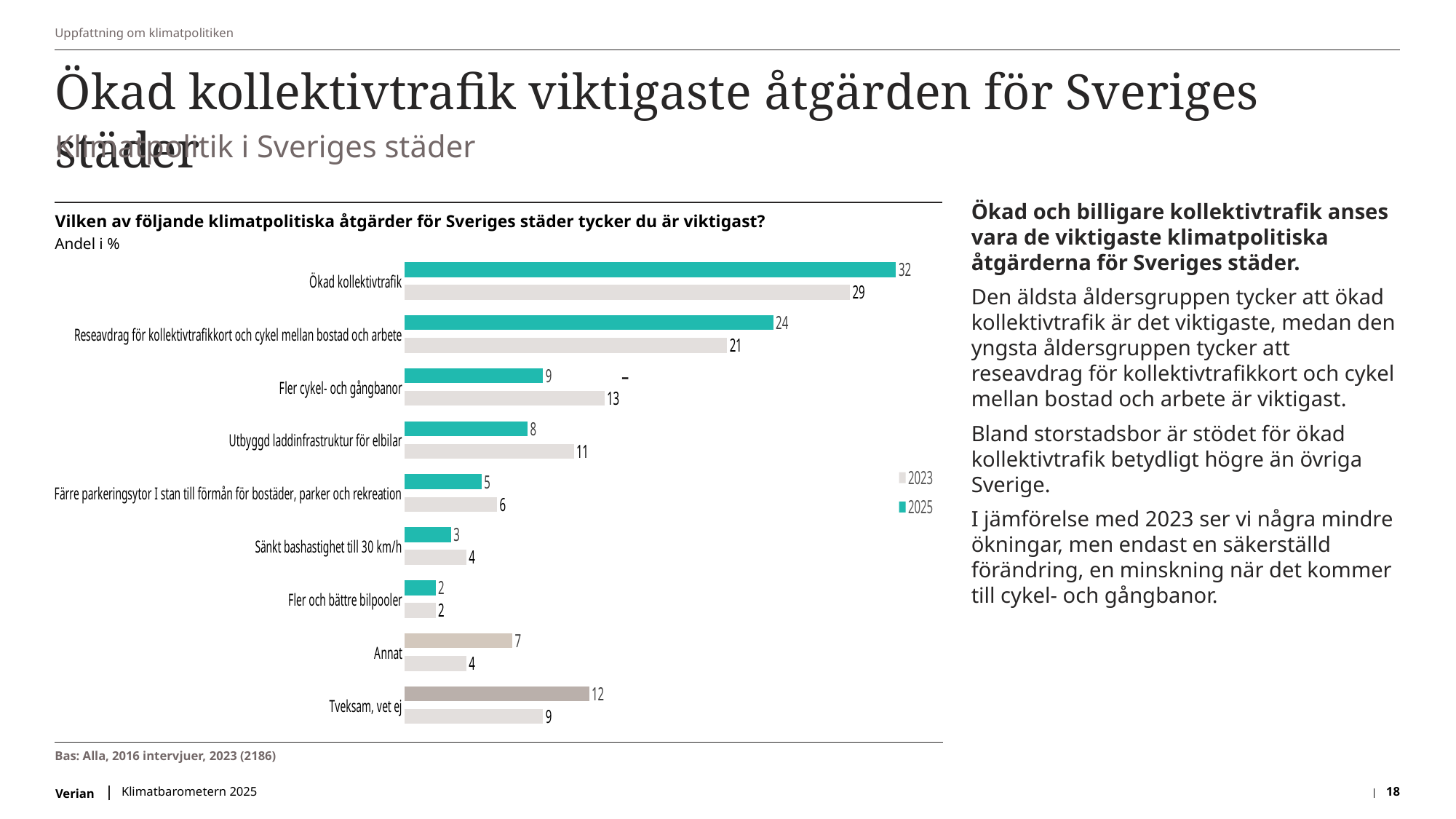
How many series does the legend list? 2 What is the 2025 value for Ökad kollektivtrafik? 32 Which is larger for Fler cykel- och gångbanor, the 2023 value or the 2025 value? 2023 How many categories are shown in the chart? 9 What unit is stated below the chart question? Andel i % What is the difference between the 2025 and 2023 values for Reseavdrag för kollektivtrafikkort och cykel mellan bostad och arbete? 3 What kind of chart is shown on the slide? Bar chart Which category has the lowest 2023 value? Fler och bättre bilpooler Which category has the highest 2025 value? Ökad kollektivtrafik What is the 2023 value for Tveksam, vet ej? 9 What is the 2023 value for Fler cykel- och gångbanor? 13 What is the 2025 value for Utbyggd laddinfrastruktur för elbilar? 8